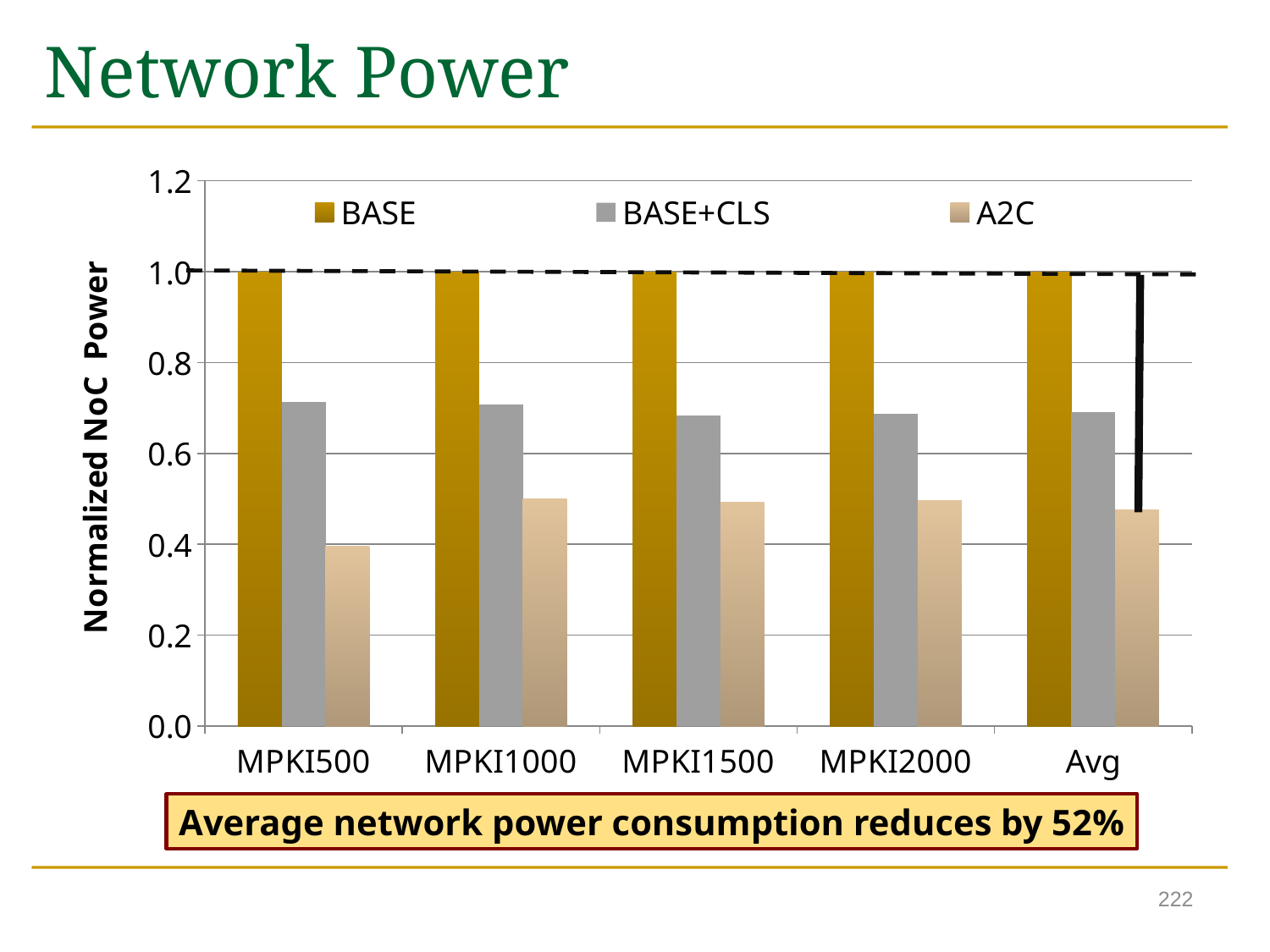
How many categories are shown on the x axis? 5 What is the label on the y axis? Normalized NoC Power Which series has the highest value at MPKI1000? BASE Which is larger at MPKI2000, BASE+CLS or A2C? BASE+CLS For the A2C series, which category has the lowest value? MPKI500 Is the value for BASE+CLS at MPKI500 greater or less than 0.8? less What kind of chart is shown on the slide? bar chart Is the value for A2C at Avg greater or less than 0.6? less How many series does the legend list? 3 What is the normalized NoC power for BASE at Avg? 1.0 What is the normalized NoC power for BASE at MPKI500? 1.0 Is the value for BASE+CLS at MPKI1500 greater or less than 0.6? greater